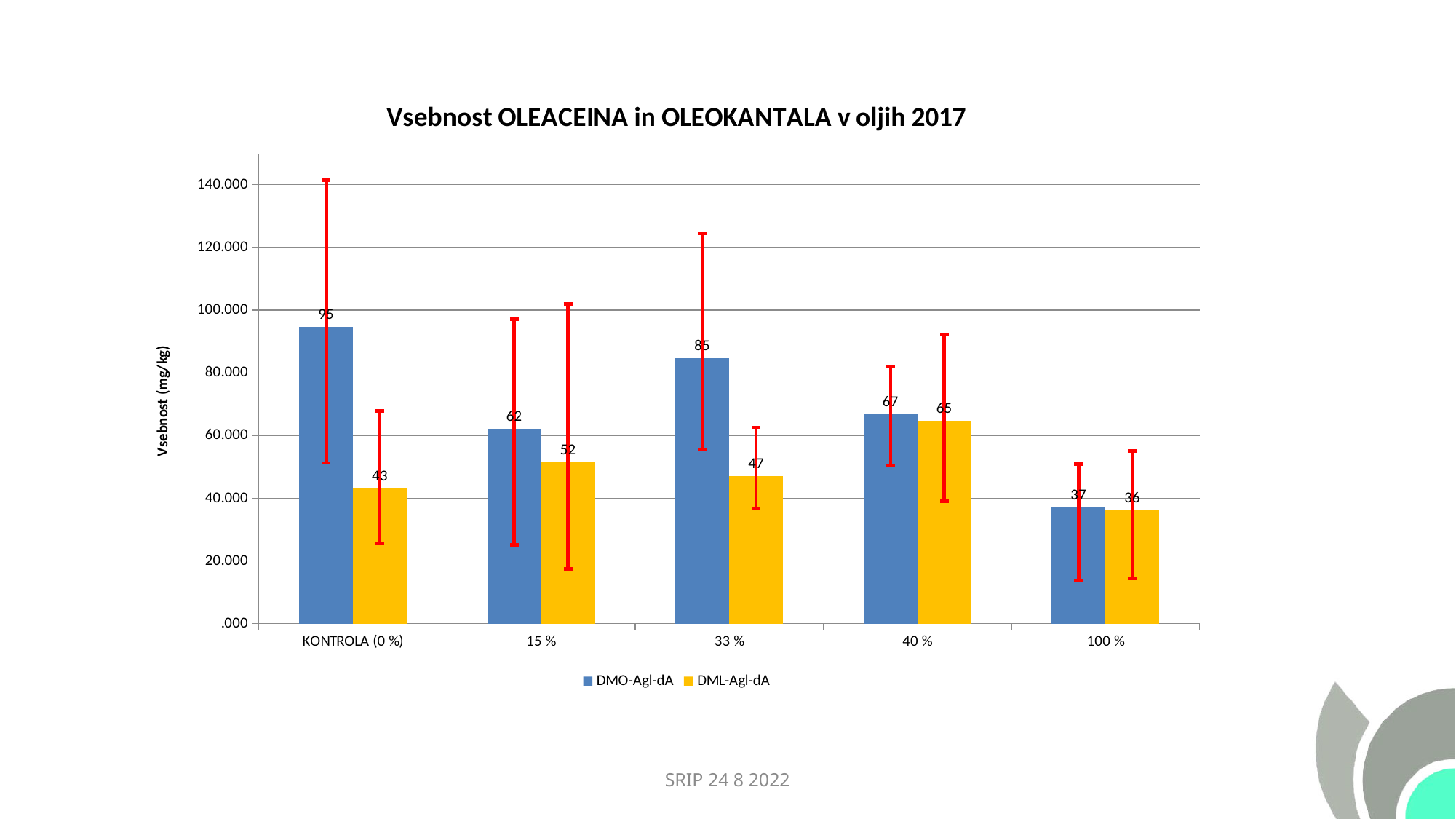
How many series does the legend list? 2 Is the DMO-Agl-dA bar at 33 % greater or less than 80.000? greater How many categories are shown on the x axis? 5 What is the difference between the DMO-Agl-dA and DML-Agl-dA labels at 33 %? 38 What is the data label for DMO-Agl-dA at KONTROLA (0 %)? 95 What is the data label for DML-Agl-dA at 15 %? 52 Which category has the highest DMO-Agl-dA value? KONTROLA (0 %) At 15 %, which series has the larger value, DMO-Agl-dA or DML-Agl-dA? DMO-Agl-dA Which category has the lowest DML-Agl-dA value? 100 % What is the y-axis title of the chart? Vsebnost (mg/kg) What kind of chart is shown on the slide? bar chart What is the data label for DML-Agl-dA at 40 %? 65